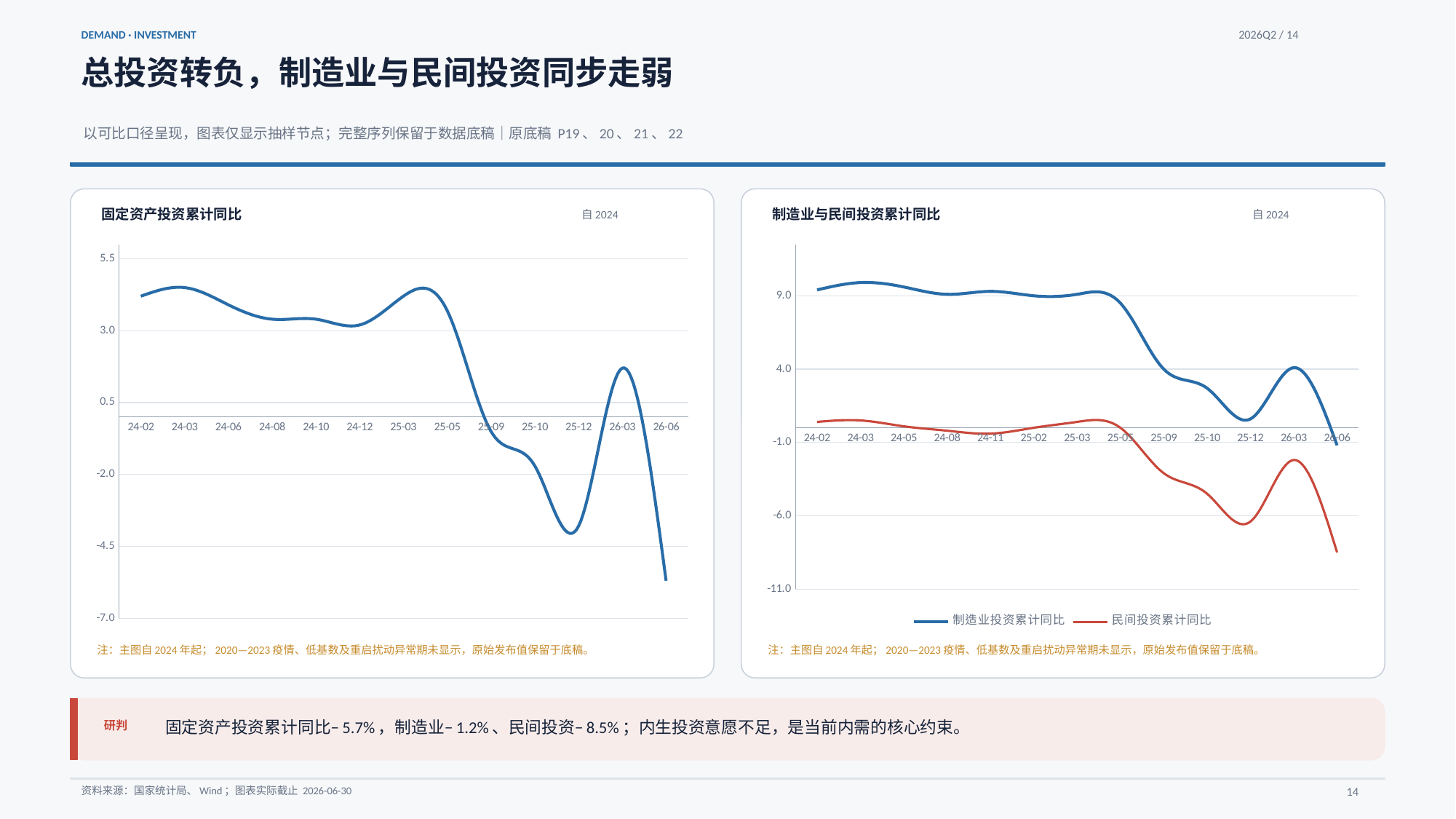
What kind of chart is the left chart titled 固定资产投资累计同比? line chart How many time points are labelled on the x axis of the left chart (固定资产投资累计同比)? 13 In the left chart (固定资产投资累计同比), is the value at 26-06 greater or less than -4.5? less In the right chart (制造业与民间投资累计同比), is the 制造业投资累计同比 value at 24-03 greater or less than 4.0? greater In the right chart (制造业与民间投资累计同比), is the 民间投资累计同比 value at 26-06 greater or less than -6.0? less In the left chart (固定资产投资累计同比), which time point has the lowest value? 26-06 In the right chart (制造业与民间投资累计同比), what colour is the 民间投资累计同比 line? red In the right chart (制造业与民间投资累计同比), does the 民间投资累计同比 series overall rise or fall from 24-02 to 26-06? fall In the right chart (制造业与民间投资累计同比), at 24-02 which series has the higher value, 制造业投资累计同比 or 民间投资累计同比? 制造业投资累计同比 How many series does the legend of the right chart (制造业与民间投资累计同比) list? 2